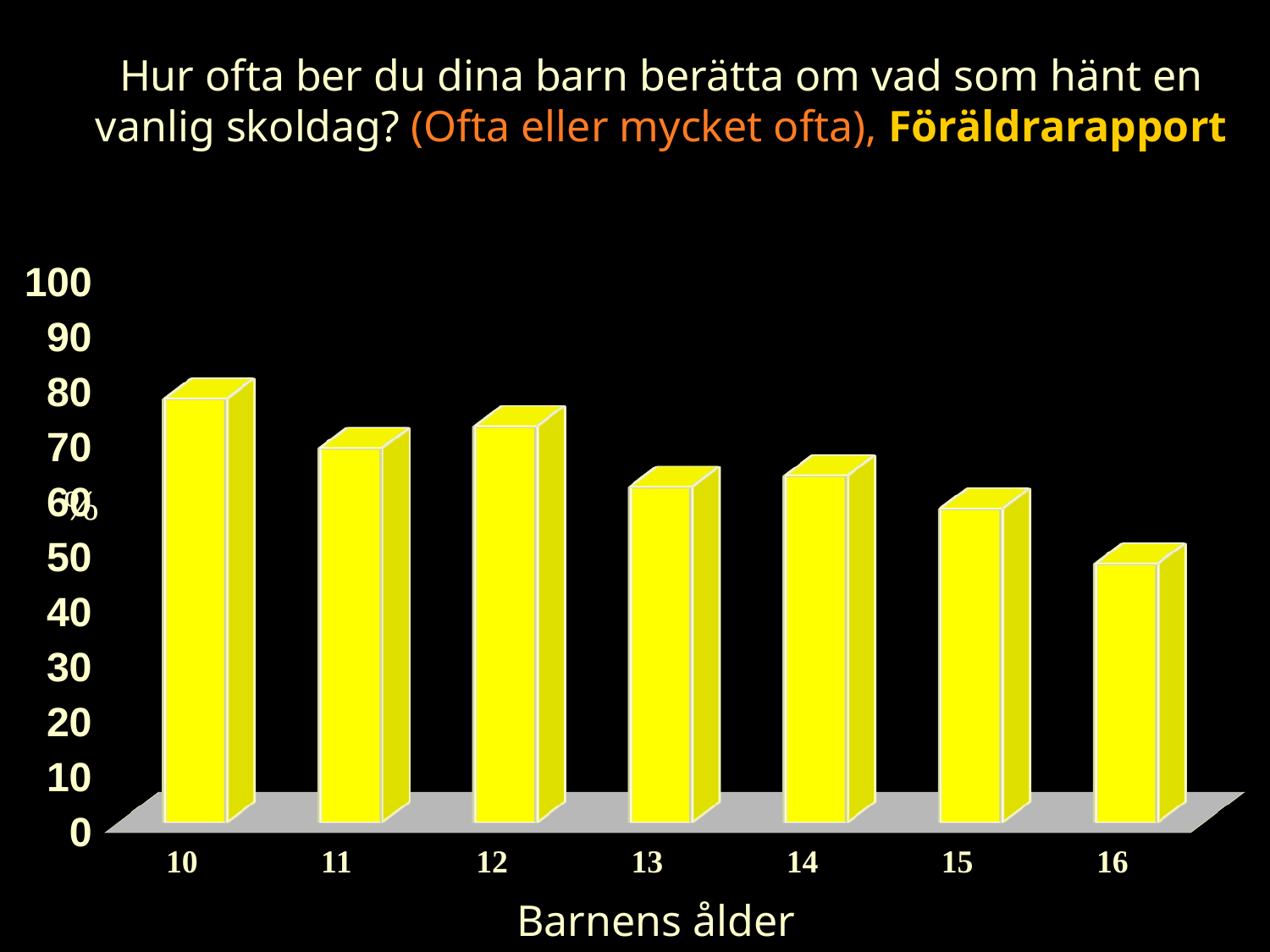
Is the value for age 11 greater or less than 60? greater Which is larger, the value for age 12 or the value for age 15? 12 Do the values generally rise or fall as the children's age increases? fall Is the value for age 16 greater or less than 60? less Which age has the lowest value? 16 How many age categories are shown on the x axis? 7 What kind of chart is shown on the slide? bar chart Is the value for age 13 greater or less than 70? less Which age has the highest value? 10 What is the title of the x axis? Barnens ålder